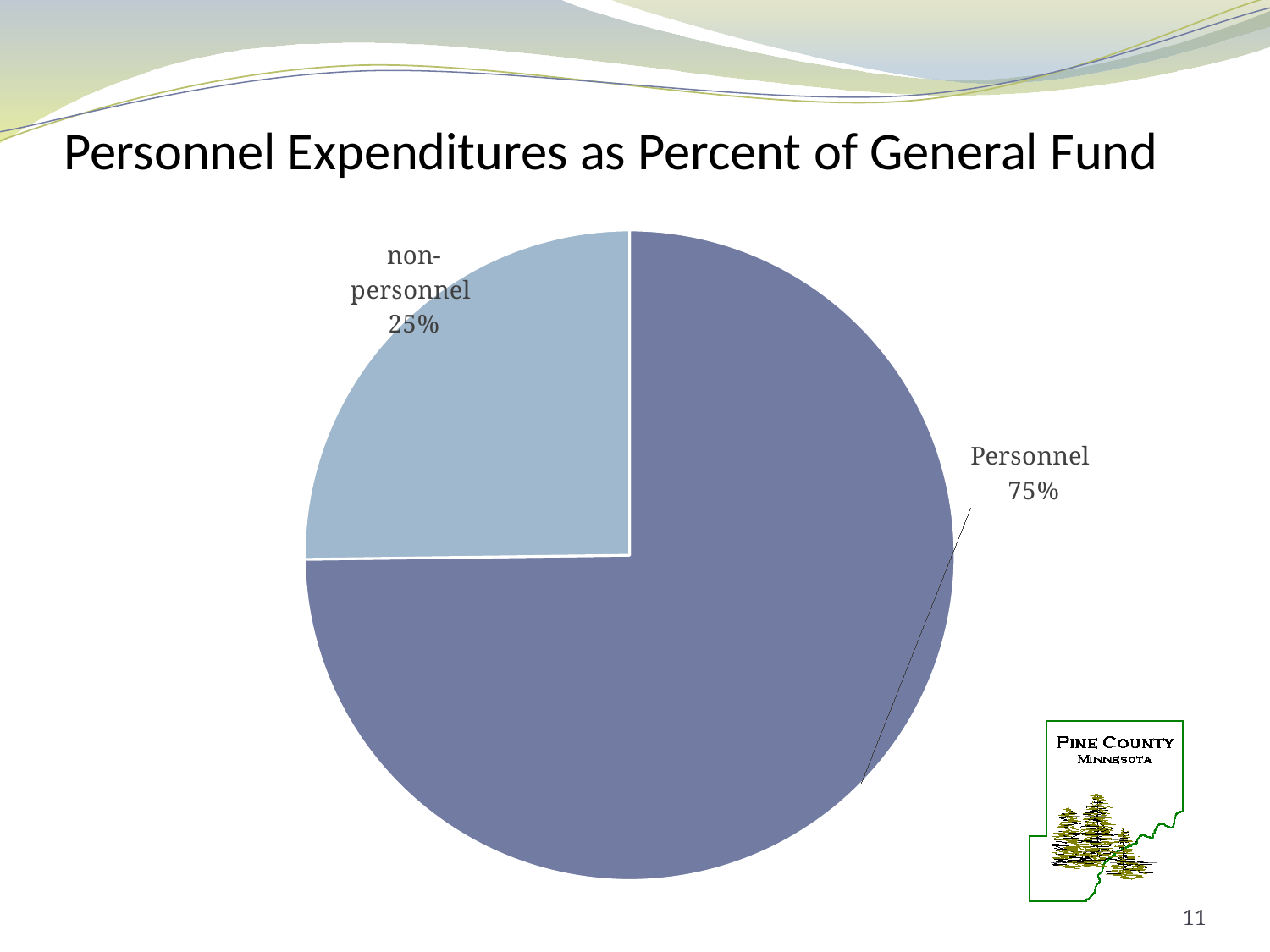
What percentage of the General Fund is shown for Personnel? 75% Which slice of the pie is the smallest? non-personnel What kind of chart is shown on the slide? pie chart What share of the pie does the Personnel slice represent? 75% Which slice of the pie is the largest? Personnel What percentage of the General Fund is shown for non-personnel? 25% How many slices does the pie chart have? 2 Which is larger, the Personnel slice or the non-personnel slice? Personnel What is the difference in percentage points between the Personnel and non-personnel slices? 50 Which slice is shown in the lighter blue colour? non-personnel What is the title of the chart on the slide? Personnel Expenditures as Percent of General Fund